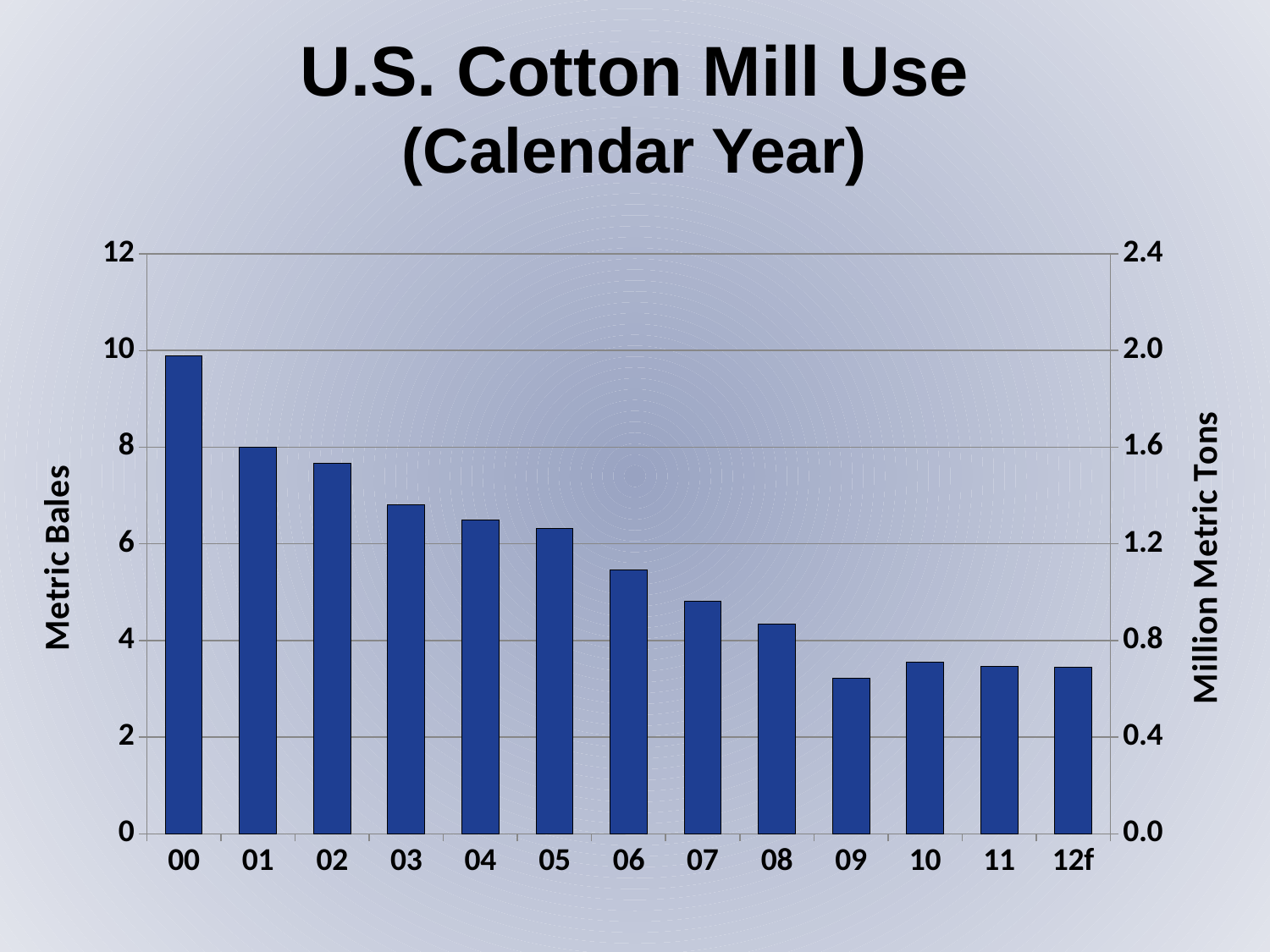
Which year has the highest cotton mill use? 00 Do the values generally rise or fall from 00 to 12f? fall What kind of chart is shown on the slide? bar chart Is the value for 03 greater or less than 6 million bales? greater Which year has the larger value, 02 or 05? 02 Is the value for 06 greater or less than 6 million bales? less What is the label on the right-hand vertical axis? Million Metric Tons Is the value for 00 greater or less than 8 million bales? greater What is the title of the chart? U.S. Cotton Mill Use (Calendar Year) Which year has the larger value, 07 or 10? 07 How many years (bars) are plotted on the chart? 13